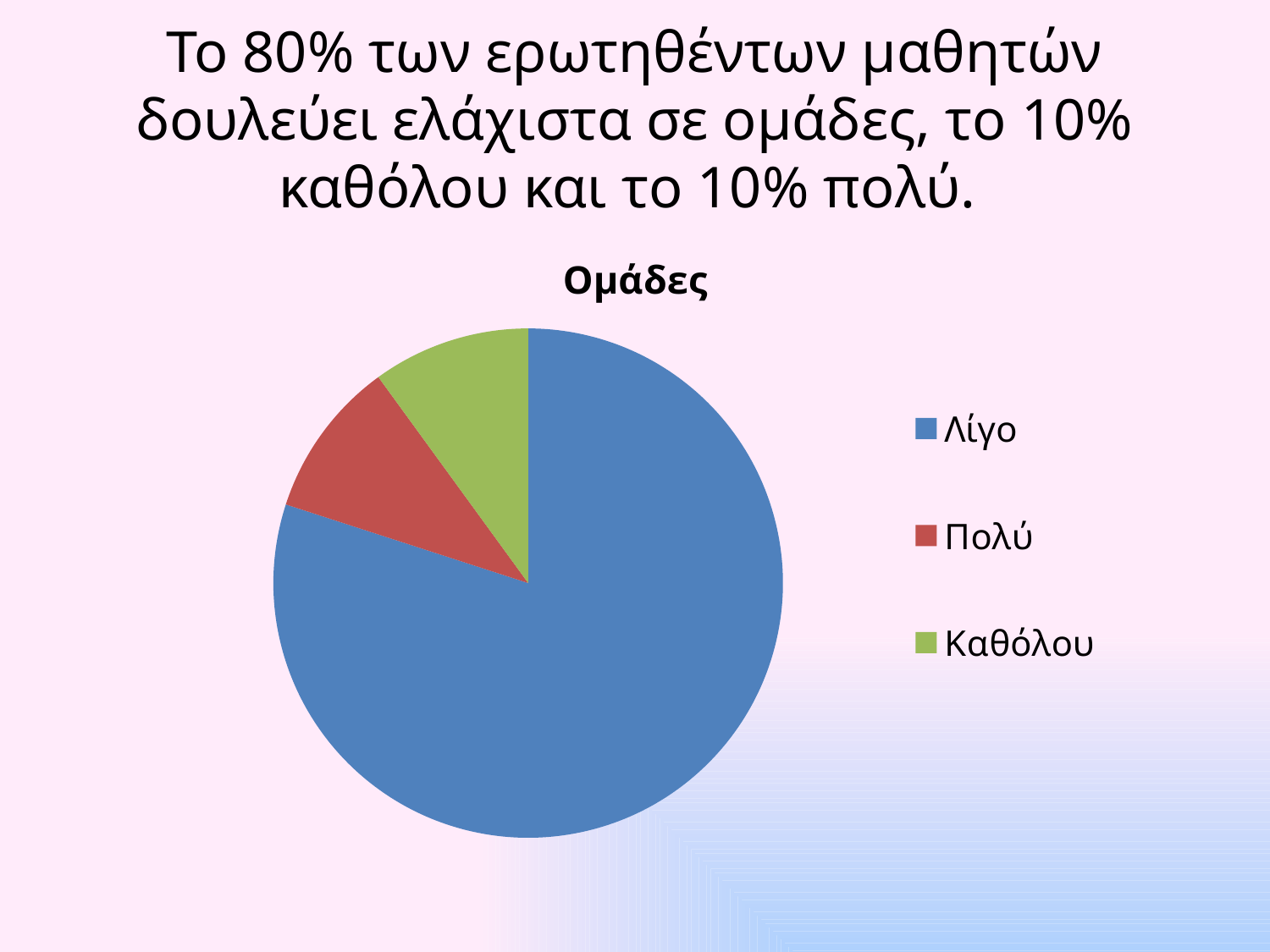
How many entries does the legend list? 3 What colour is the Λίγο slice? blue What kind of chart is shown on the slide? pie chart Which slice is larger, Λίγο or Πολύ? Λίγο How many slices does the pie chart have? 3 Which category has the largest slice of the pie? Λίγο What share of the pie does the Λίγο slice represent? 80% What share of the pie does the Πολύ slice represent? 10% What share of the pie does the Καθόλου slice represent? 10% What is the title of the chart? Ομάδες Which slice is larger, Λίγο or Καθόλου? Λίγο